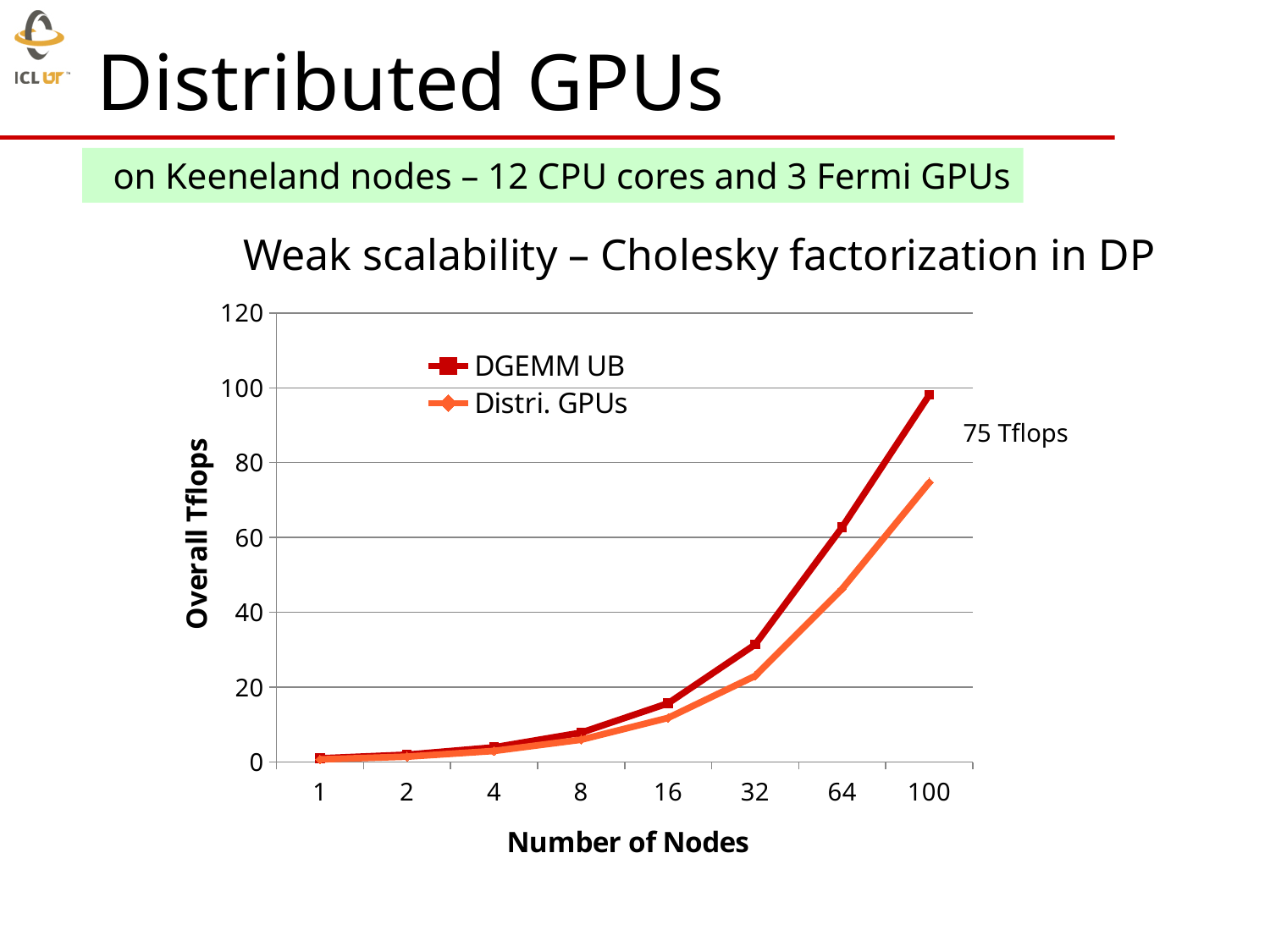
Is the DGEMM UB value at 32 nodes greater or less than 40? less At 100 nodes, which series has the larger value, DGEMM UB or Distri. GPUs? DGEMM UB How many series does the chart legend list? 2 Is the Distri. GPUs value at 64 nodes greater or less than 60? less Do the values for DGEMM UB rise or fall as the number of nodes increases? rise What is the title of the chart? Weak scalability – Cholesky factorization in DP What kind of chart is shown on the slide? line chart At which number of nodes is the DGEMM UB value lowest? 1 At which number of nodes does the Distri. GPUs series reach its highest value? 100 Is the DGEMM UB value at 100 nodes greater or less than 80? greater How many node counts are plotted along the x axis? 8